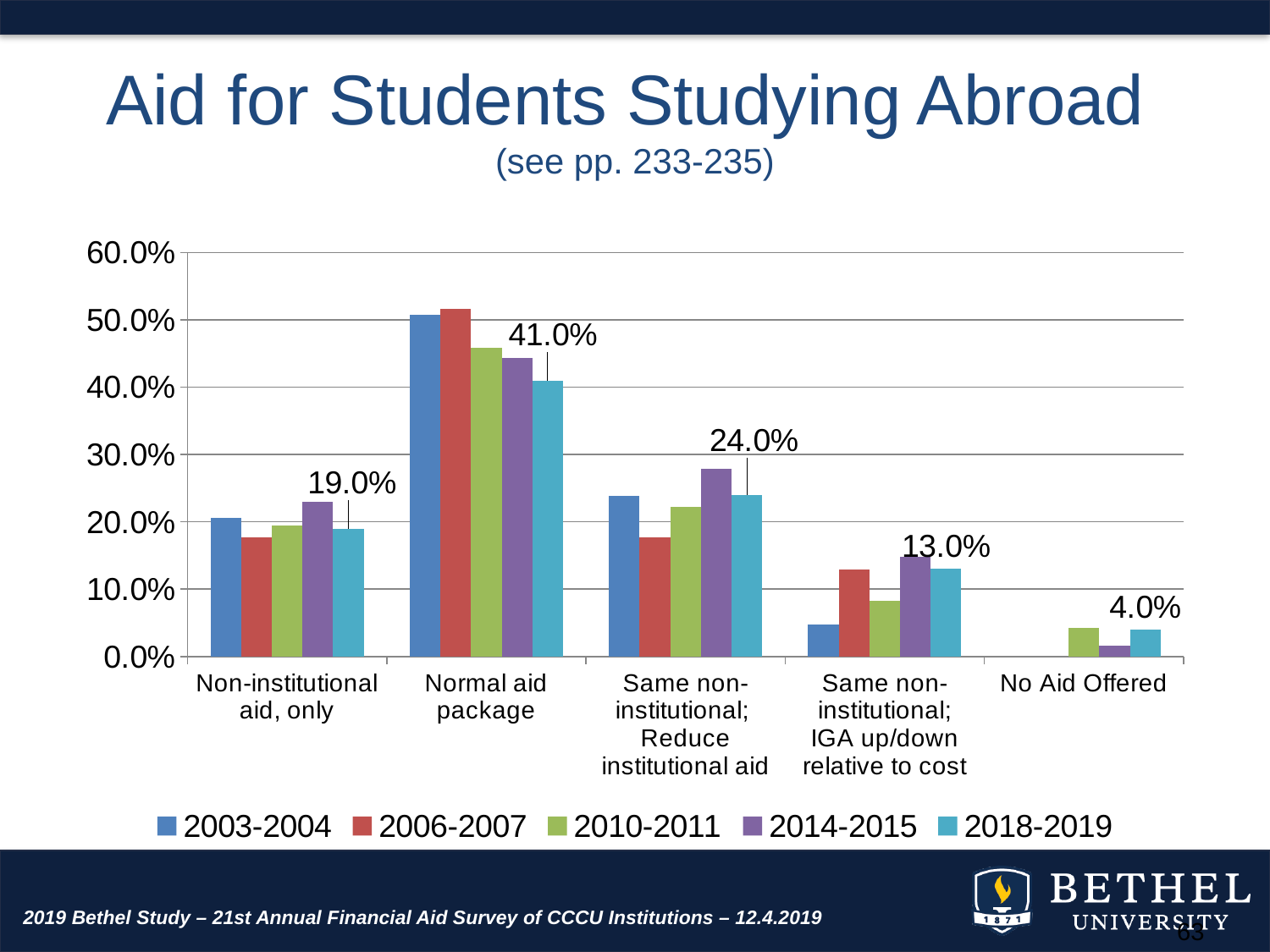
What kind of chart is shown on the slide? Bar chart Among the 2018-2019 values, which category is highest? Normal aid package How many series does the legend list? 5 What is the 2018-2019 value for Same non-institutional; Reduce institutional aid? 24.0% What is the difference between the 2018-2019 values for Normal aid package and Same non-institutional; Reduce institutional aid? 17.0% What is the 2018-2019 value for No Aid Offered? 4.0% Is the 2014-2015 value for Same non-institutional; Reduce institutional aid greater or less than 30.0%? less Among the 2018-2019 values, which category is lowest? No Aid Offered For 2018-2019, which is larger: Non-institutional aid, only or Same non-institutional; IGA up/down relative to cost? Non-institutional aid, only How many categories are shown on the x axis? 5 Is the 2003-2004 value for Same non-institutional; IGA up/down relative to cost greater or less than 10.0%? less What is the 2018-2019 value for Normal aid package? 41.0%